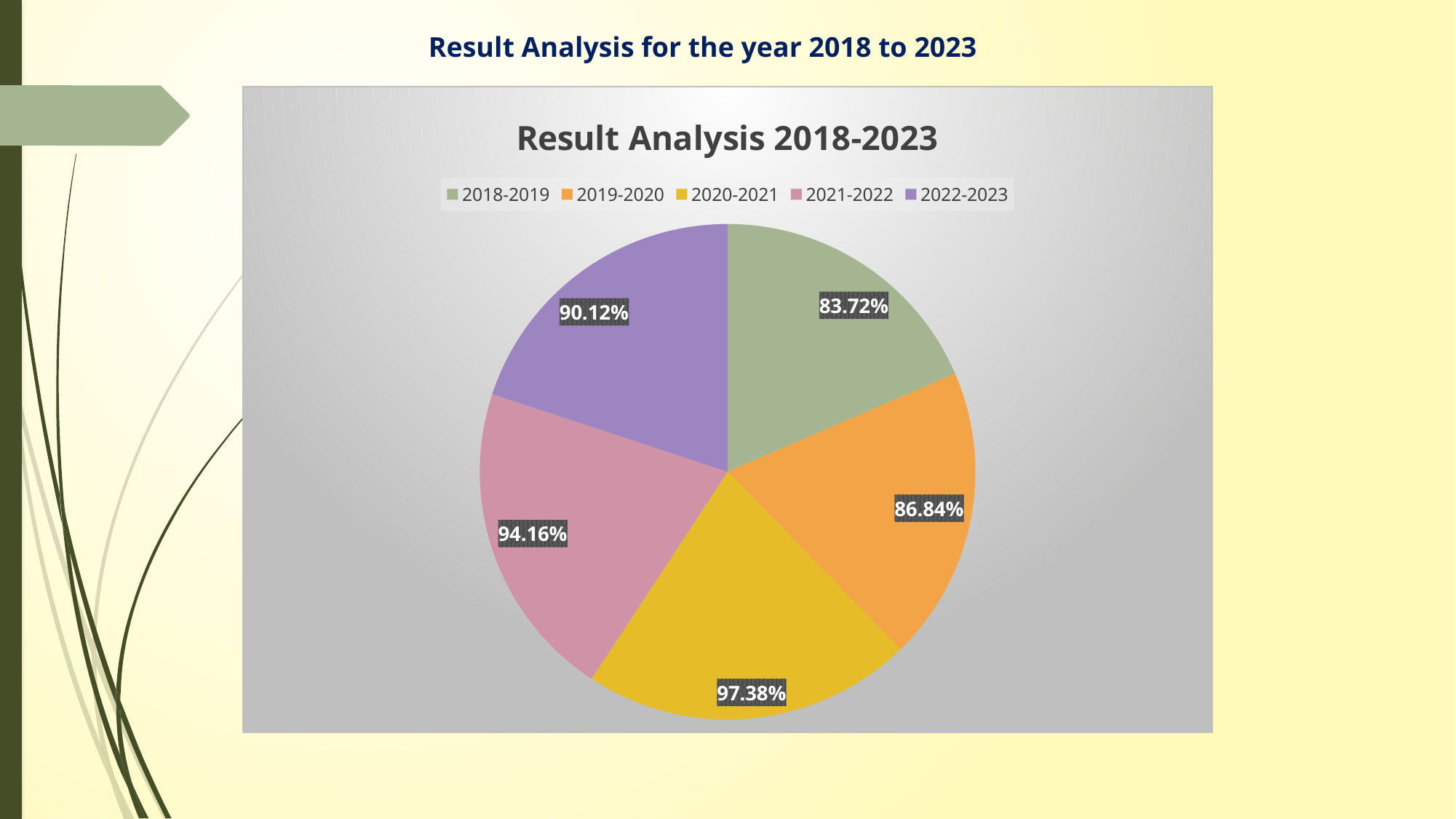
What type of chart is shown on the slide? Pie chart Which is larger, the value for 2021-2022 or the value for 2022-2023? 2021-2022 How many slices does the pie chart have? 5 What is the value shown for 2018-2019? 83.72% What is the value shown for 2019-2020? 86.84% What is the value shown for 2022-2023? 90.12% Which year has the lowest value? 2018-2019 What is the difference between the values for 2020-2021 and 2018-2019? 13.66% What is the value shown for 2020-2021? 97.38% Which year has the highest value? 2020-2021 What is the value shown for 2021-2022? 94.16% What is the title of the chart? Result Analysis 2018-2023